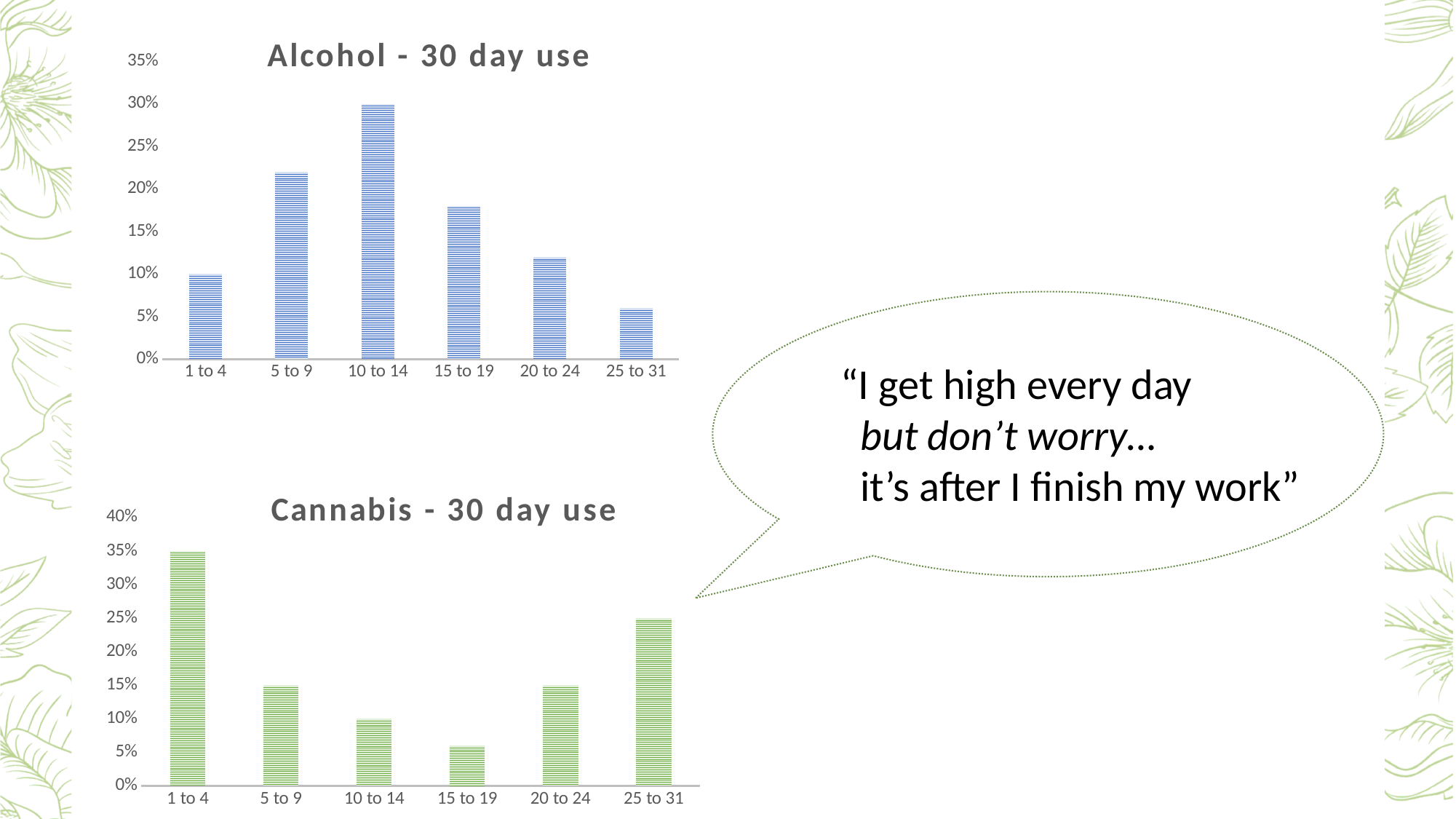
In the 'Cannabis - 30 day use' chart, is the value for 25 to 31 greater or less than 20%? greater In the 'Alcohol - 30 day use' chart, which category has the lowest value? 25 to 31 What type of chart is the 'Alcohol - 30 day use' chart? bar chart In the 'Alcohol - 30 day use' chart, is the value for 5 to 9 greater or less than 20%? greater In the 'Alcohol - 30 day use' chart, is the value for 25 to 31 greater or less than 10%? less In the 'Cannabis - 30 day use' chart, which category has the lowest value? 15 to 19 In the 'Cannabis - 30 day use' chart, which category has the highest value? 1 to 4 What is the title of the lower chart on the slide? Cannabis - 30 day use In the 'Cannabis - 30 day use' chart, which is larger, the value for 25 to 31 or the value for 10 to 14? 25 to 31 How many categories are shown on the x axis of the 'Alcohol - 30 day use' chart? 6 In the 'Alcohol - 30 day use' chart, do the values rise or fall from 10 to 14 through 25 to 31? fall In the 'Alcohol - 30 day use' chart, which category has the highest value? 10 to 14